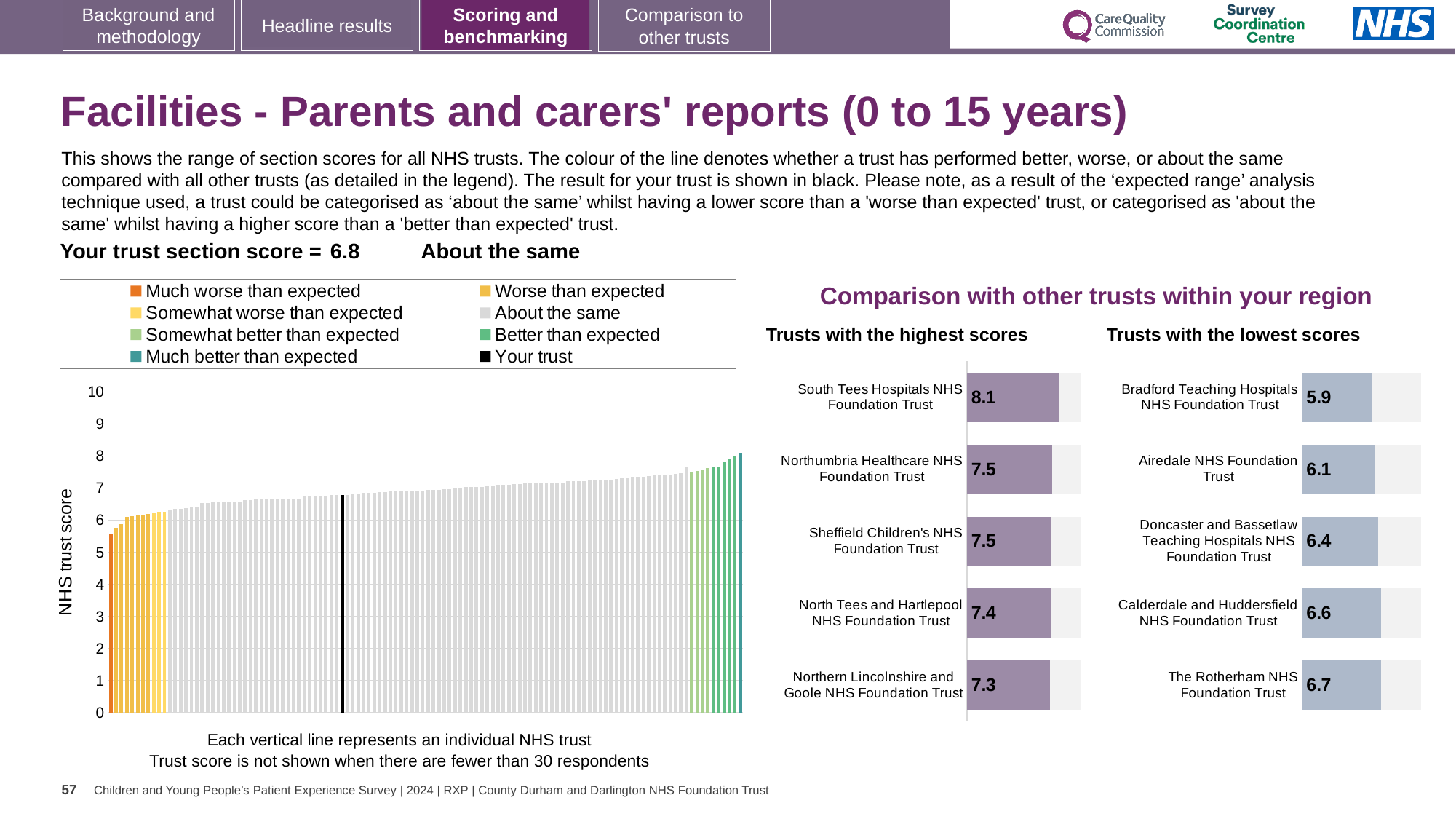
In the 'Trusts with the lowest scores' chart, which trust has the lowest score? Bradford Teaching Hospitals NHS Foundation Trust In the 'Trusts with the highest scores' chart, how many trusts are shown? 5 In the 'Trusts with the lowest scores' chart, what is the score for Doncaster and Bassetlaw Teaching Hospitals NHS Foundation Trust? 6.4 In the large chart on the left, what is the section score for your trust (the black bar)? 6.8 In the 'Trusts with the highest scores' chart, what is the score for South Tees Hospitals NHS Foundation Trust? 8.1 In the large chart on the left, is the value of the lowest (orange) bar greater or less than 6? less In the 'Trusts with the highest scores' chart, which trust has the highest score? South Tees Hospitals NHS Foundation Trust How many entries does the legend of the large chart on the left list? 8 In the 'Trusts with the highest scores' chart, what is the difference between the scores of South Tees Hospitals NHS Foundation Trust and Northern Lincolnshire and Goole NHS Foundation Trust? 0.8 In the 'Trusts with the lowest scores' chart, what is the difference between the scores of The Rotherham NHS Foundation Trust and Bradford Teaching Hospitals NHS Foundation Trust? 0.8 In the 'Trusts with the lowest scores' chart, which has the larger score: Airedale NHS Foundation Trust or Calderdale and Huddersfield NHS Foundation Trust? Calderdale and Huddersfield NHS Foundation Trust What kind of chart is the large chart on the left showing NHS trust scores? Bar chart